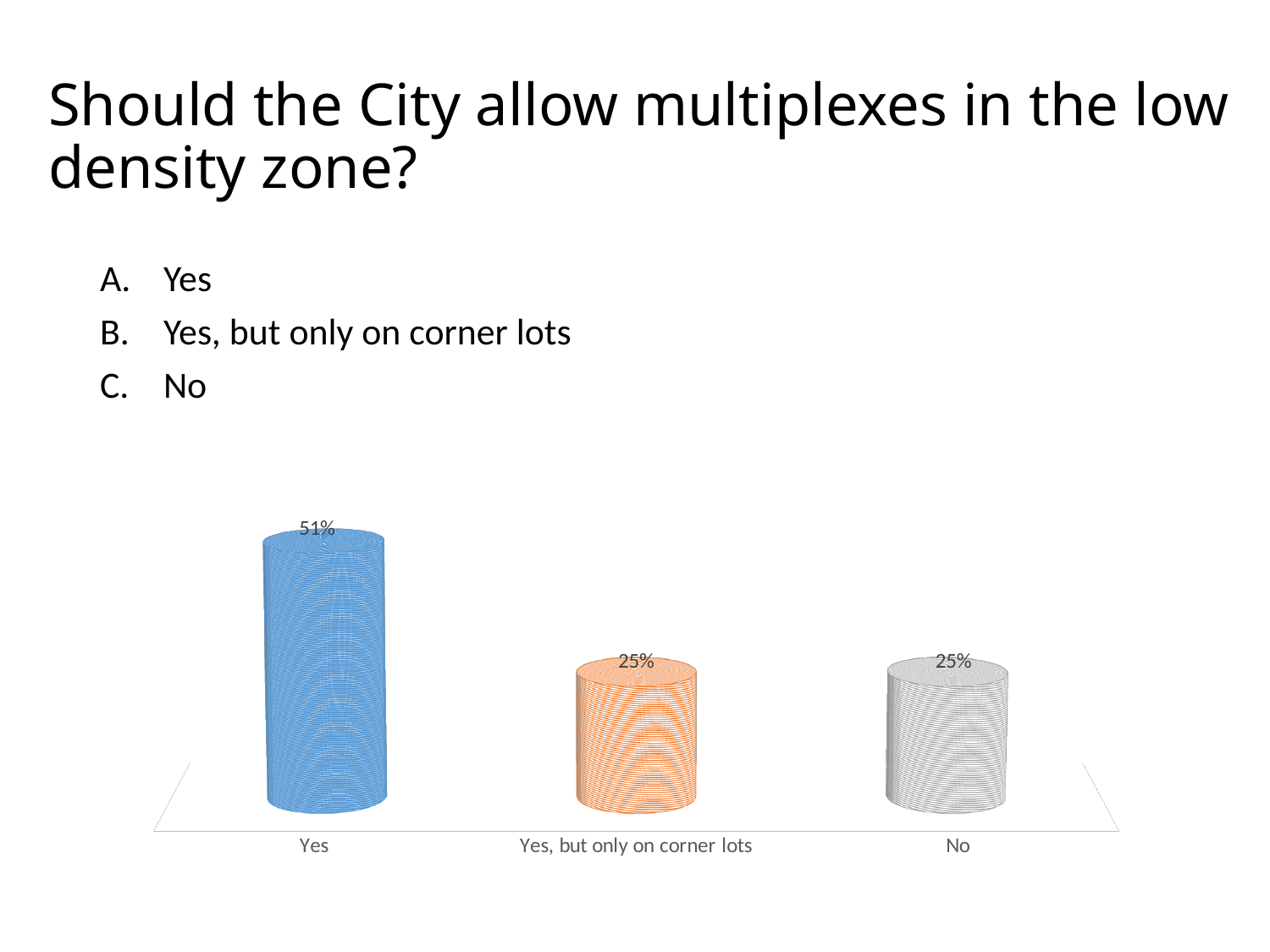
What percentage of respondents answered "No"? 25% What colour is the bar for "Yes"? Blue What percentage of respondents answered "Yes"? 51% What is the total of the three percentages shown in the chart? 101% How many response categories are shown in the chart? 3 Do the values for "Yes, but only on corner lots" and "No" differ? No, both are 25% What is the difference between the "Yes" value and the "No" value? 26% What question does the slide title ask? Should the City allow multiplexes in the low density zone? What percentage of respondents answered "Yes, but only on corner lots"? 25% What kind of chart is shown on the slide? Bar chart Which is larger, the value for "Yes" or the value for "Yes, but only on corner lots"? Yes Which response category has the highest value? Yes